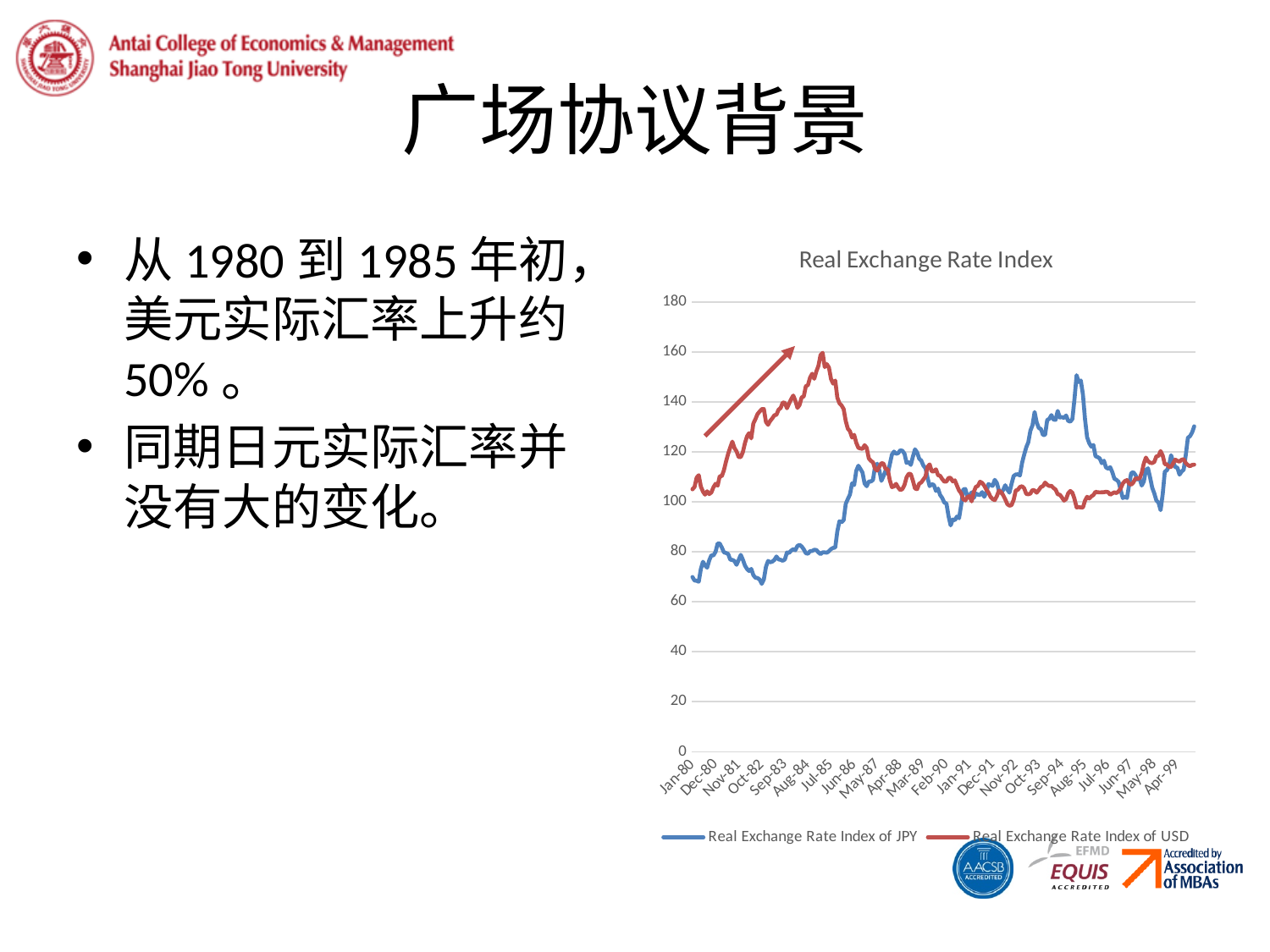
Is the value of the Real Exchange Rate Index of USD at Jan-80 greater or less than 80? greater What is the title of the chart? Real Exchange Rate Index Is the peak value of the Real Exchange Rate Index of JPY around 1995 greater or less than 140? greater Is the peak value of the Real Exchange Rate Index of USD around 1985 greater or less than 140? greater What kind of chart is shown on the slide? line chart Does the Real Exchange Rate Index of USD rise or fall from its 1985 peak to 1988? fall Does the Real Exchange Rate Index of USD rise or fall from Jan-80 to early 1985? rise Which colour is used for the Real Exchange Rate Index of USD line? red At Jan-80, which series has the higher value, JPY or USD? Real Exchange Rate Index of USD How many series does the legend of the chart list? 2 Around Sep-94, which series has the higher value, JPY or USD? Real Exchange Rate Index of JPY